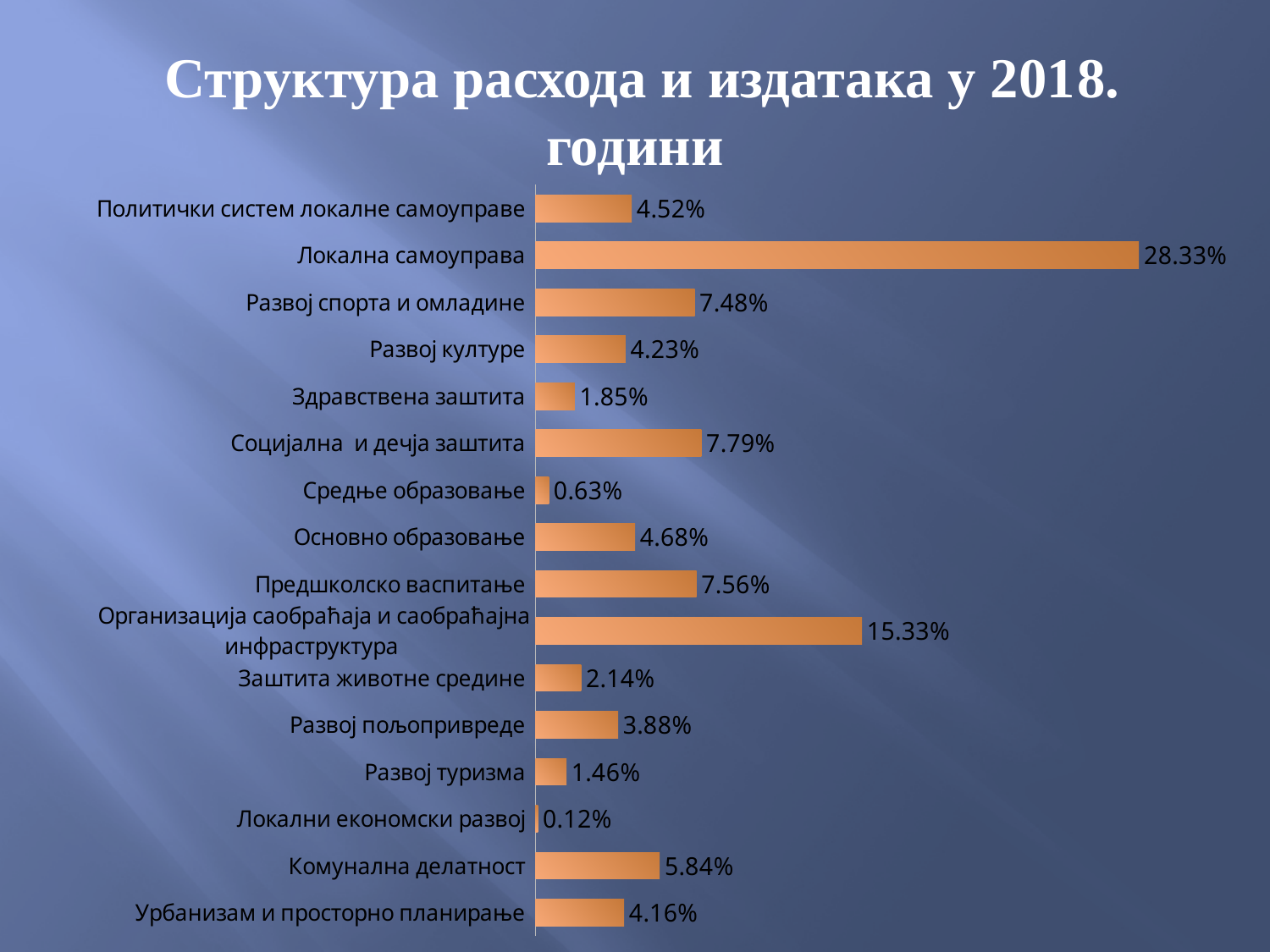
What is the difference between the values for Локална самоуправа and Организација саобраћаја и саобраћајна инфраструктура? 13.00% How many categories are shown in the chart? 16 Which category has the highest value? Локална самоуправа What is the value for Здравствена заштита? 1.85% What kind of chart is shown on the slide? Bar chart What is the difference between the values for Социјална и дечја заштита and Развој културе? 3.56% Which category has the lowest value? Локални економски развој What is the value for Организација саобраћаја и саобраћајна инфраструктура? 15.33% Which is larger, the value for Предшколско васпитање or the value for Основно образовање? Предшколско васпитање What is the value for Комунална делатност? 5.84% What is the value for Локална самоуправа? 28.33% What is the title of the slide? Структура расхода и издатака у 2018. години